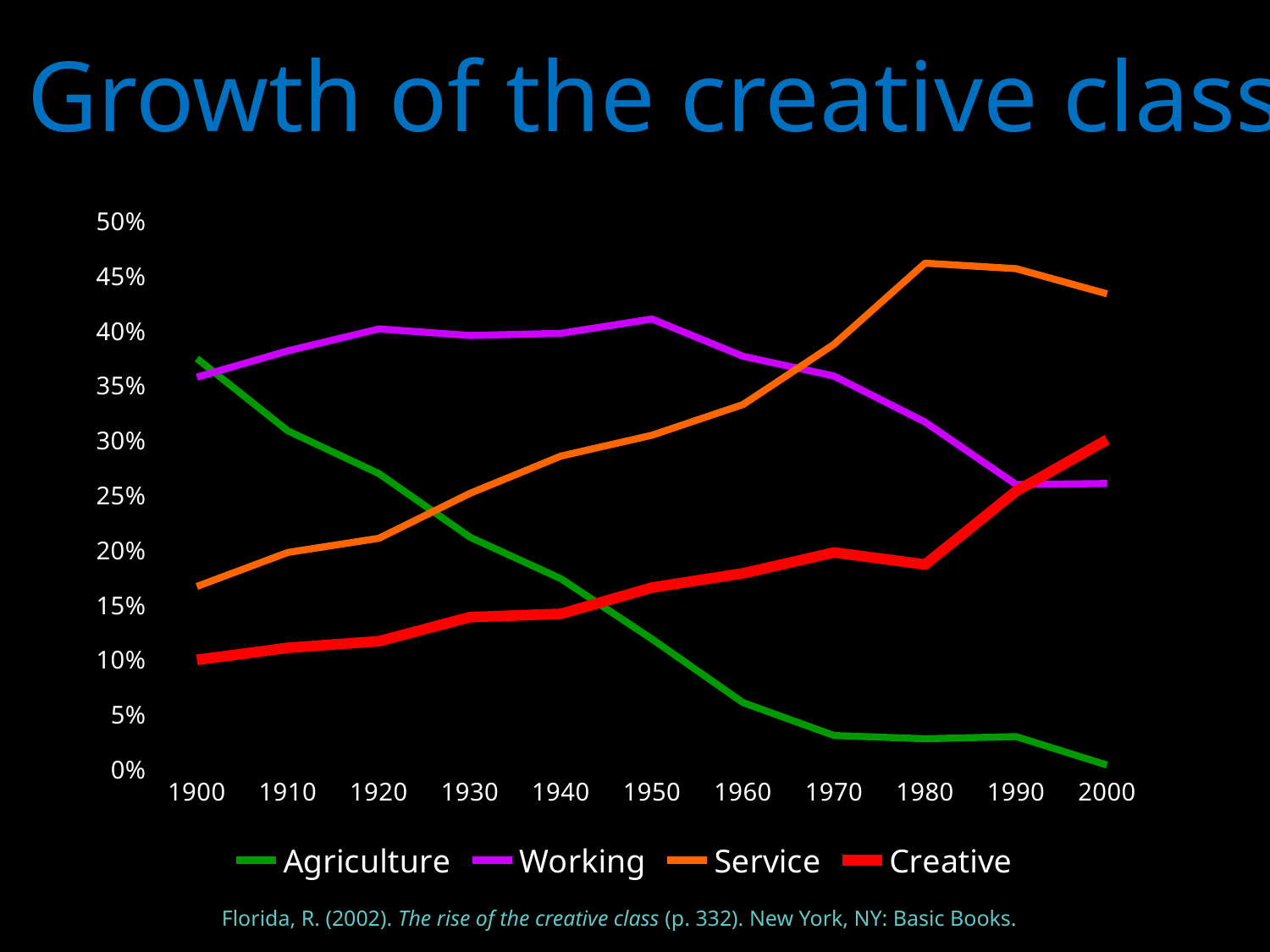
Is the value for Creative in 2000 greater or less than 25%? greater Is the value for Agriculture in 1900 greater or less than 35%? greater How many years are marked along the x axis? 11 Is the value for Service in 1980 greater or less than 40%? greater What kind of chart is shown on the slide? line chart How many series does the legend list? 4 Does the Service line rise or fall from 1900 to 1980? rise In 2000, which is larger, the Service value or the Working value? Service Which series has the lowest value in 2000? Agriculture Does the Agriculture line rise or fall from 1900 to 2000? fall Which series has the highest value in 1950? Working